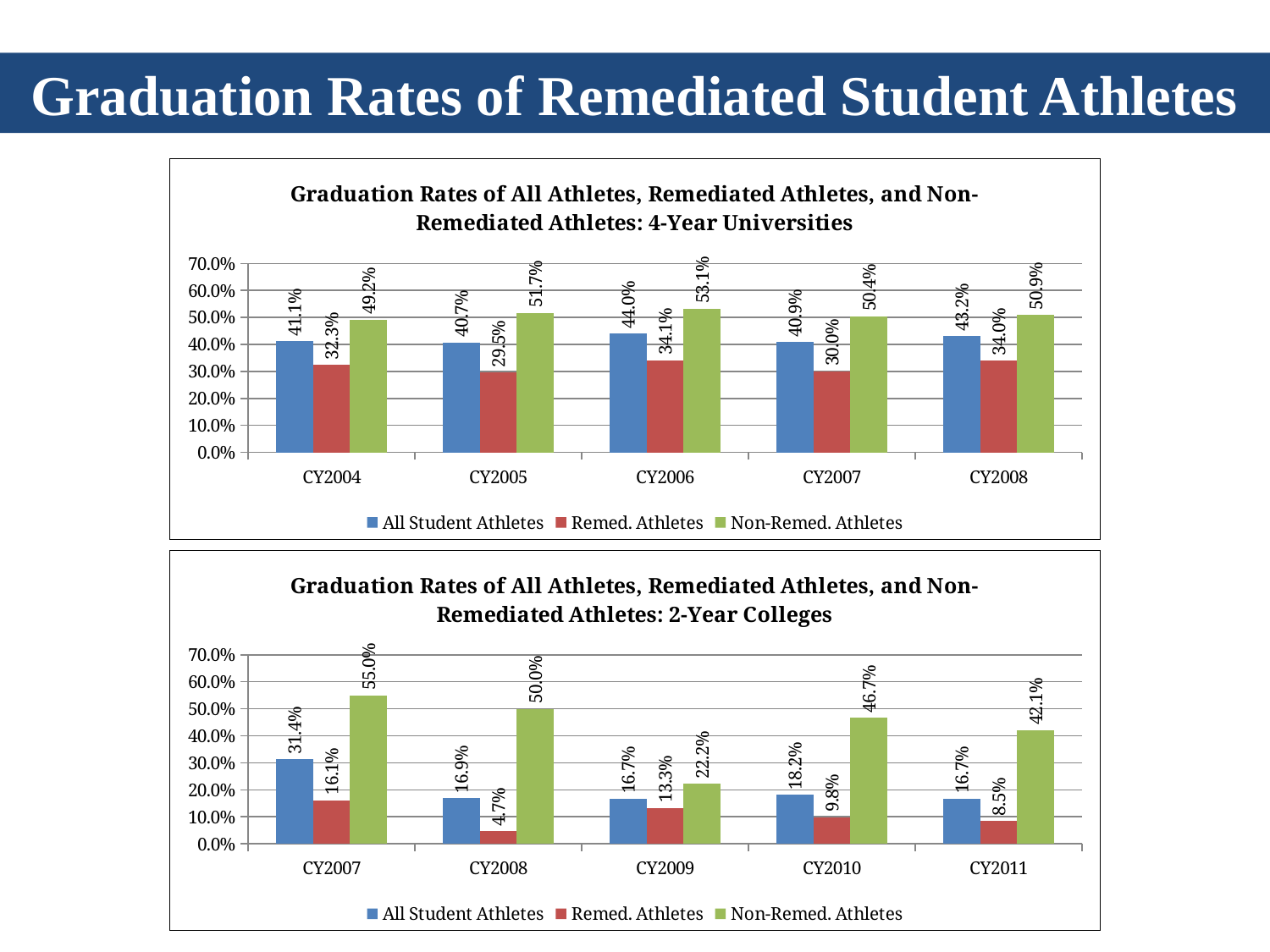
In the 2-Year Colleges chart, what is the difference between the Non-Remed. Athletes rates in CY2007 and CY2011? 12.9% In the 4-Year Universities chart, how many series does the legend list? 3 In the 4-Year Universities chart, what is the difference between the Non-Remed. Athletes and Remed. Athletes graduation rates in CY2004? 16.9% In the 2-Year Colleges chart, how many years are shown on the x axis? 5 In the 2-Year Colleges chart, what is the graduation rate for Remed. Athletes in CY2008? 4.7% In the 2-Year Colleges chart, which year has the lowest graduation rate for Non-Remed. Athletes? CY2009 In the 4-Year Universities chart, which year has the highest graduation rate for All Student Athletes? CY2006 In the 4-Year Universities chart, what is the graduation rate for Non-Remed. Athletes in CY2006? 53.1% In the 4-Year Universities chart, what is the graduation rate for Remed. Athletes in CY2005? 29.5% In the 4-Year Universities chart, what colour represents Non-Remed. Athletes? Green In the 2-Year Colleges chart, which is larger: the All Student Athletes rate in CY2007 or in CY2010? CY2007 What kind of chart is the 2-Year Colleges chart? Bar chart